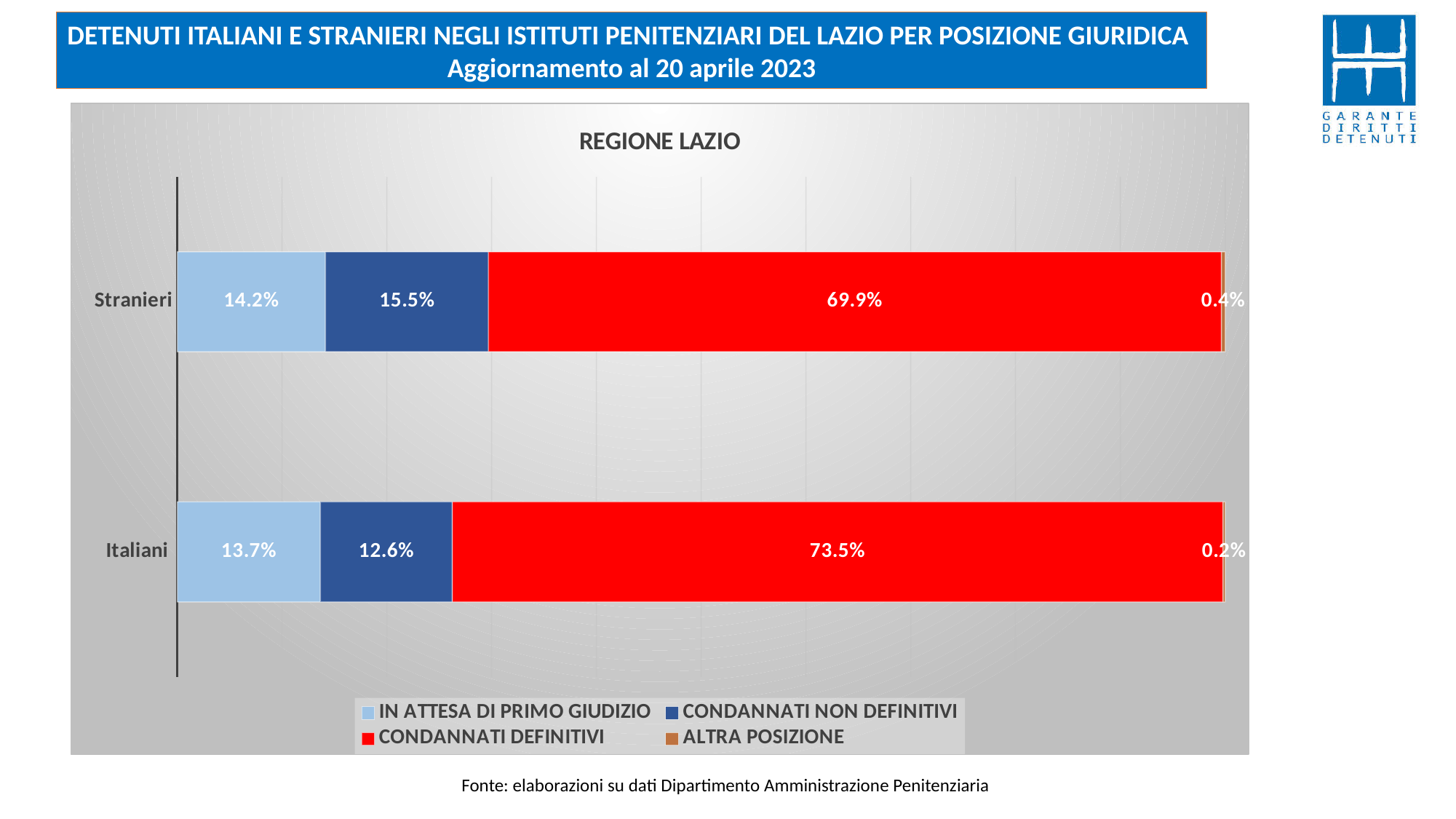
What kind of chart is shown on the slide? Stacked bar chart What percentage of Stranieri are CONDANNATI DEFINITIVI? 69.9% What percentage of Italiani are IN ATTESA DI PRIMO GIUDIZIO? 13.7% What is the difference between the CONDANNATI DEFINITIVI share for Italiani and for Stranieri? 3.6% What is the value for ALTRA POSIZIONE among Italiani? 0.2% How many series does the legend list? 4 Which category has the higher share of CONDANNATI DEFINITIVI, Stranieri or Italiani? Italiani Which series is the smallest segment in the Italiani bar? ALTRA POSIZIONE Which series is the largest segment in the Stranieri bar? CONDANNATI DEFINITIVI How many categories are shown on the chart? 2 What is the value for CONDANNATI NON DEFINITIVI among Stranieri? 15.5% What is the difference between the CONDANNATI NON DEFINITIVI share for Stranieri and for Italiani? 2.9%